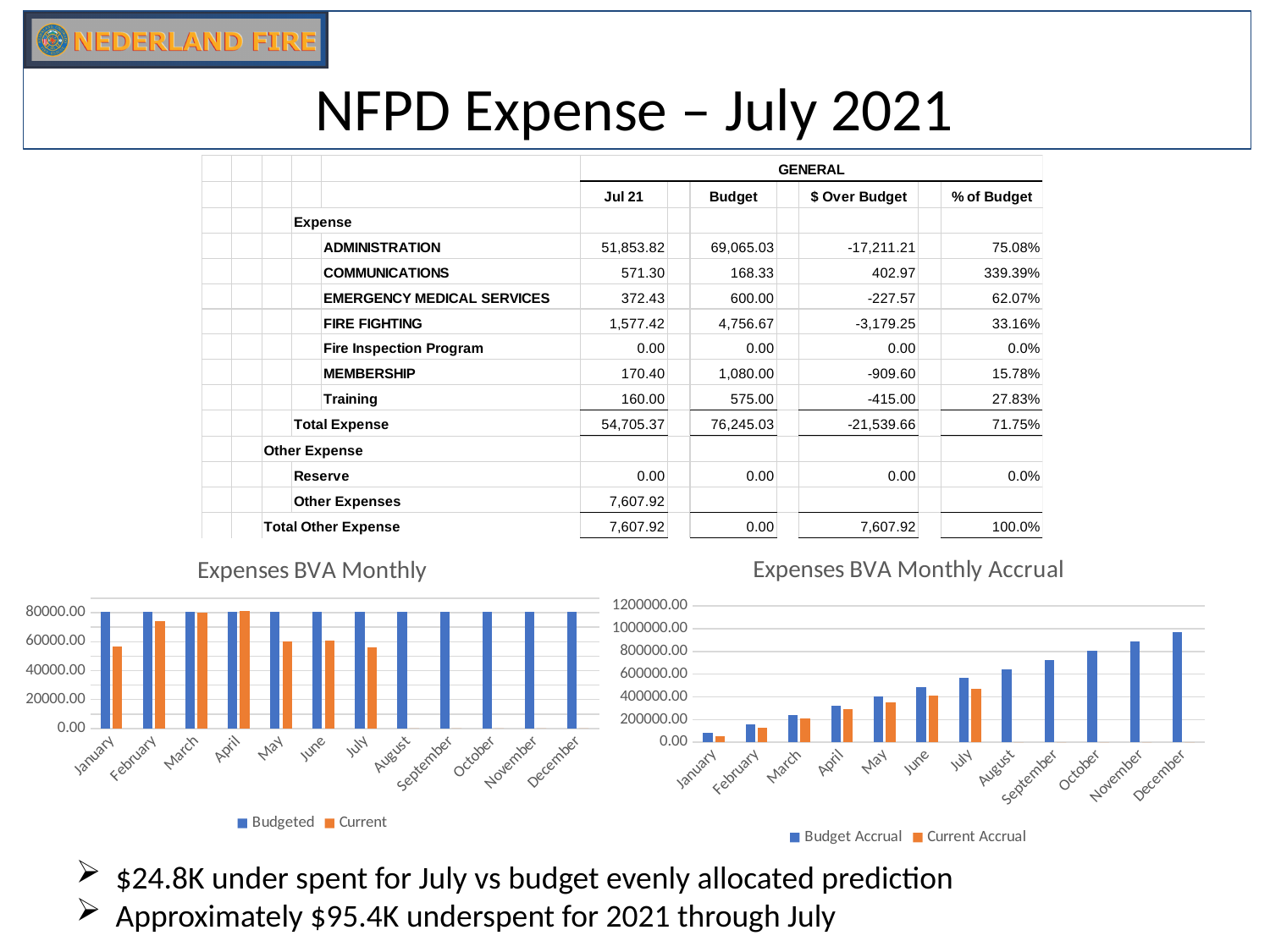
In the "Expenses BVA Monthly Accrual" chart, do the Budget Accrual values rise or fall from January to December? Rise What are the two legend entries of the "Expenses BVA Monthly" chart? Budgeted and Current In the "Expenses BVA Monthly Accrual" chart, is the Budget Accrual value for December greater or less than 800000? greater In the "Expenses BVA Monthly" chart, which is larger for January: the Budgeted value or the Current value? Budgeted How many series does the legend of the "Expenses BVA Monthly Accrual" chart list? 2 In the "Expenses BVA Monthly Accrual" chart, which month has the lowest Budget Accrual value? January In the "Expenses BVA Monthly" chart, is the Current value for January greater or less than 80000? less In the "Expenses BVA Monthly Accrual" chart, is the Current Accrual value for July greater or less than 600000? less In the "Expenses BVA Monthly Accrual" chart, which month has the highest Budget Accrual value? December In the "Expenses BVA Monthly Accrual" chart, which is larger for July: Budget Accrual or Current Accrual? Budget Accrual What kind of chart is the "Expenses BVA Monthly" chart on the left? Bar chart How many months are shown on the x axis of the "Expenses BVA Monthly" chart? 12